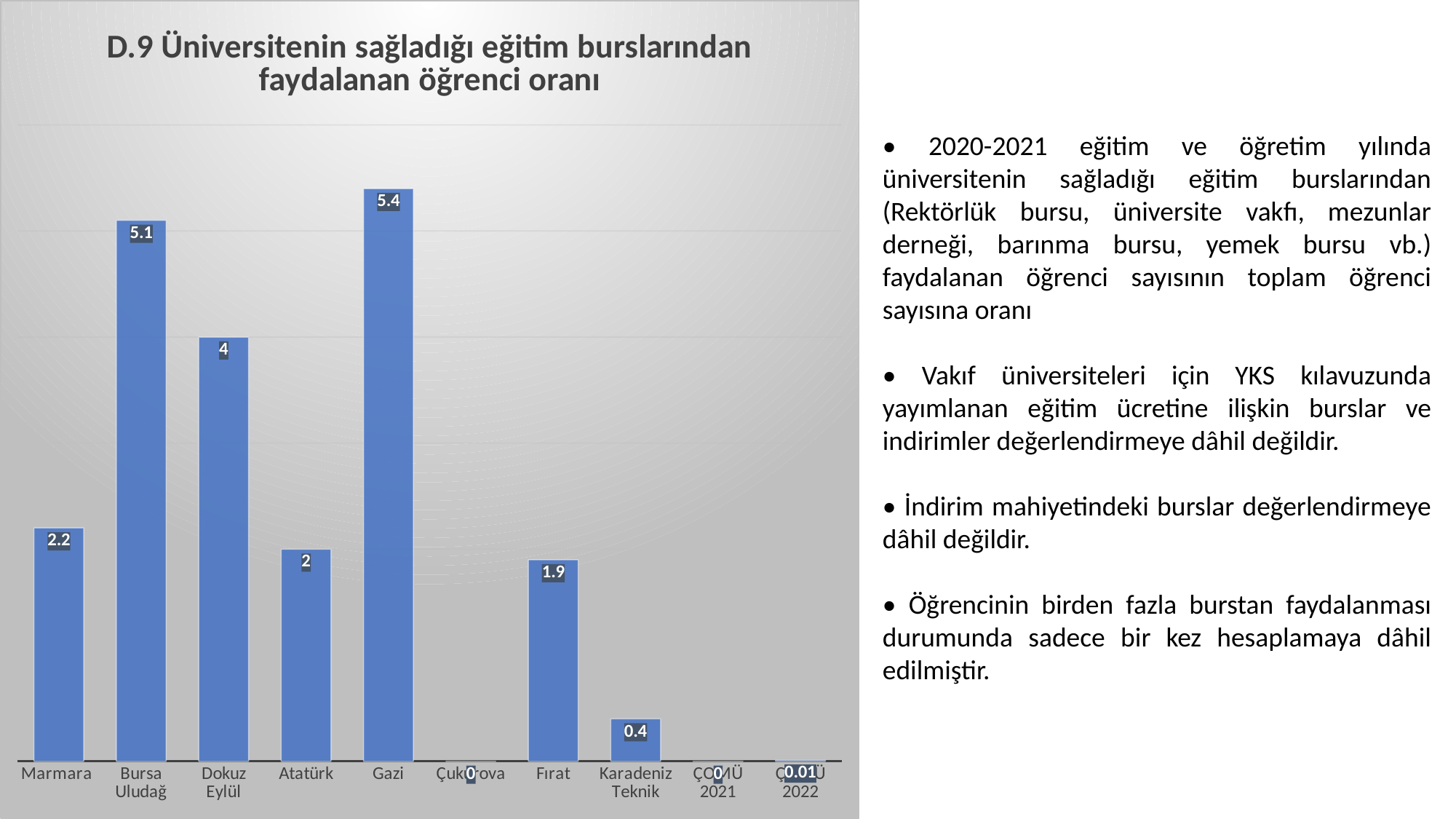
What is the title of the chart? D.9 Üniversitenin sağladığı eğitim burslarından faydalanan öğrenci oranı What is the value for Bursa Uludağ? 5.1 What is the value for ÇOMÜ 2022? 0.01 What is the value for Karadeniz Teknik? 0.4 What is the value for Gazi? 5.4 What is the difference between the values for Dokuz Eylül and Atatürk? 2 What is the difference between the values for Gazi and Bursa Uludağ? 0.3 What is the value for Marmara? 2.2 Which university has the highest value? Gazi What kind of chart is this? Bar chart How many universities/categories are shown on the x axis? 10 Which is larger, the value for Marmara or the value for Fırat? Marmara